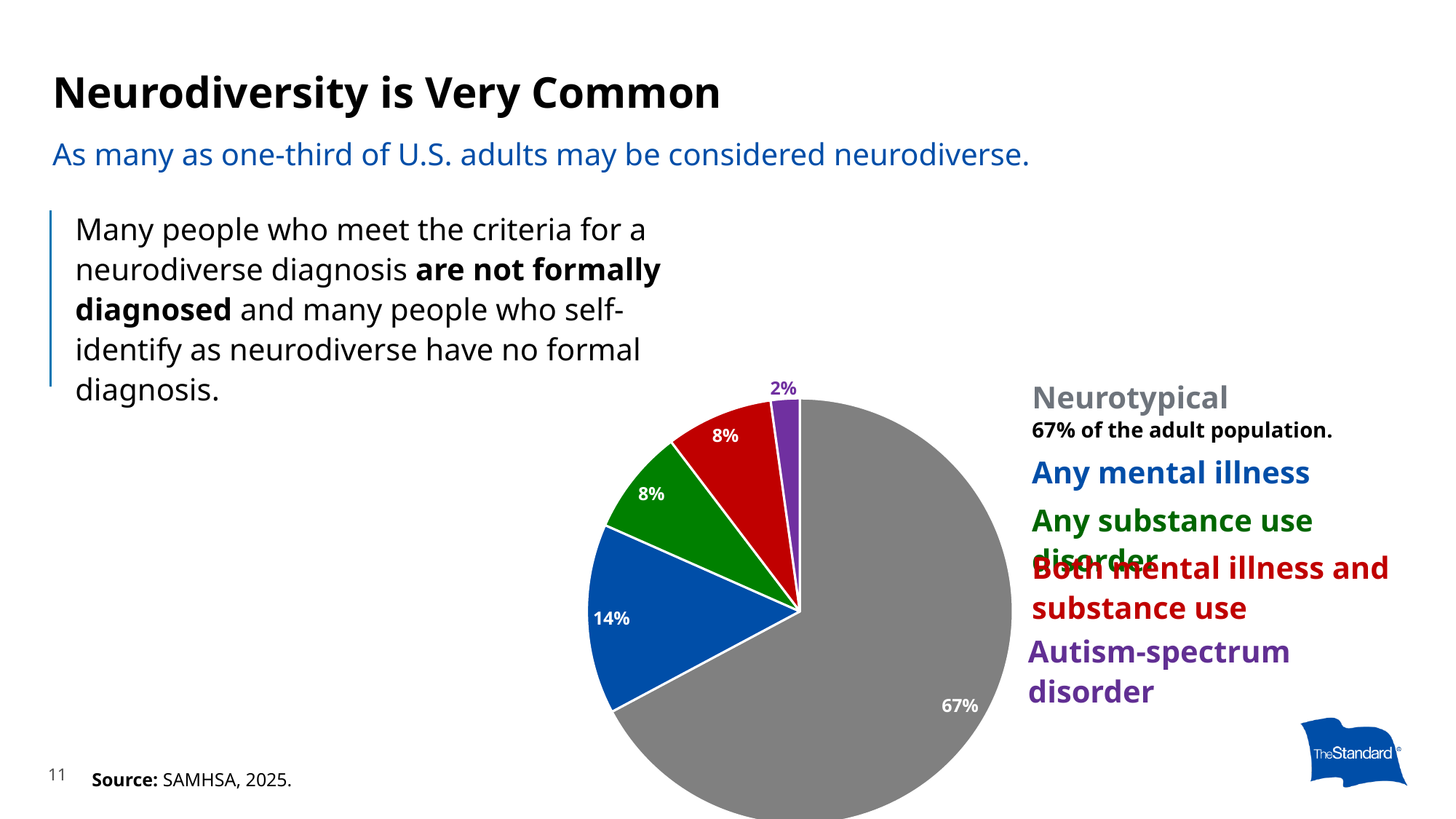
What kind of chart is shown on the slide? pie chart What percentage is shown for the Autism-spectrum disorder slice? 2% What percentage of the pie is labelled for the Neurotypical slice? 67% What colour is the Autism-spectrum disorder slice of the pie? purple What is the difference in percentage points between the Neurotypical slice and the Any mental illness slice? 53 Which is larger, the Any mental illness slice or the Both mental illness and substance use slice? Any mental illness How many slices does the pie chart have? 5 What colour is the Neurotypical slice of the pie? gray Which slice of the pie is the smallest? Autism-spectrum disorder What percentage is shown for the Any substance use disorder slice? 8% Which slice of the pie is the largest? Neurotypical What percentage is shown for the Any mental illness slice? 14%